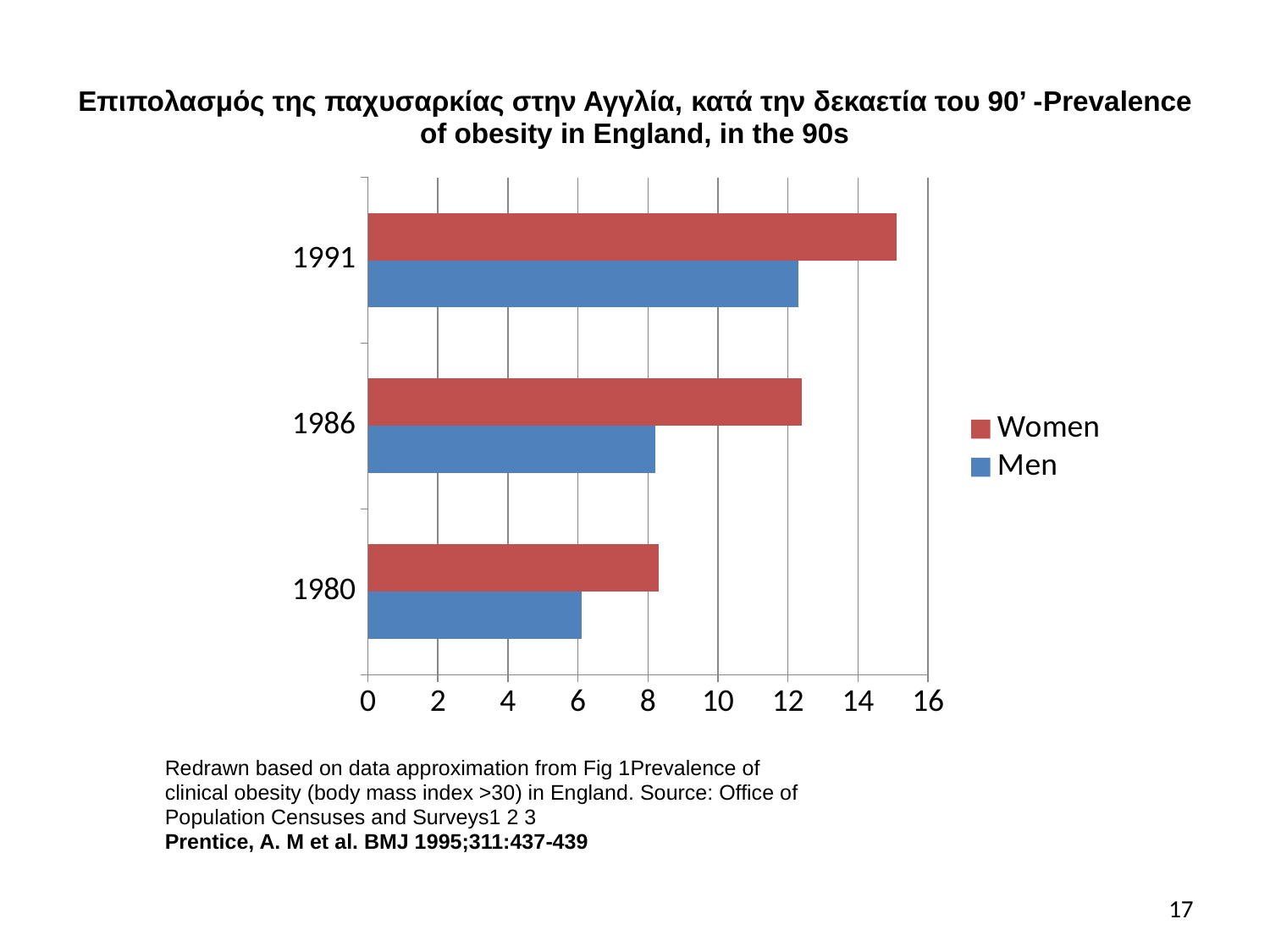
Is the value for Women in 1986 greater or less than 10? greater In which year is the Women value highest? 1991 How many years are shown on the chart? 3 Is the value for Women in 1991 greater or less than 14? greater Is the value for Men in 1986 greater or less than 10? less In 1991, which is larger, the value for Women or the value for Men? Women What kind of chart is shown on the slide? bar chart How many series does the legend list? 2 Which colour represents Women in the legend? red Do the Men values rise or fall from 1980 to 1991? rise In which year is the Men value lowest? 1980